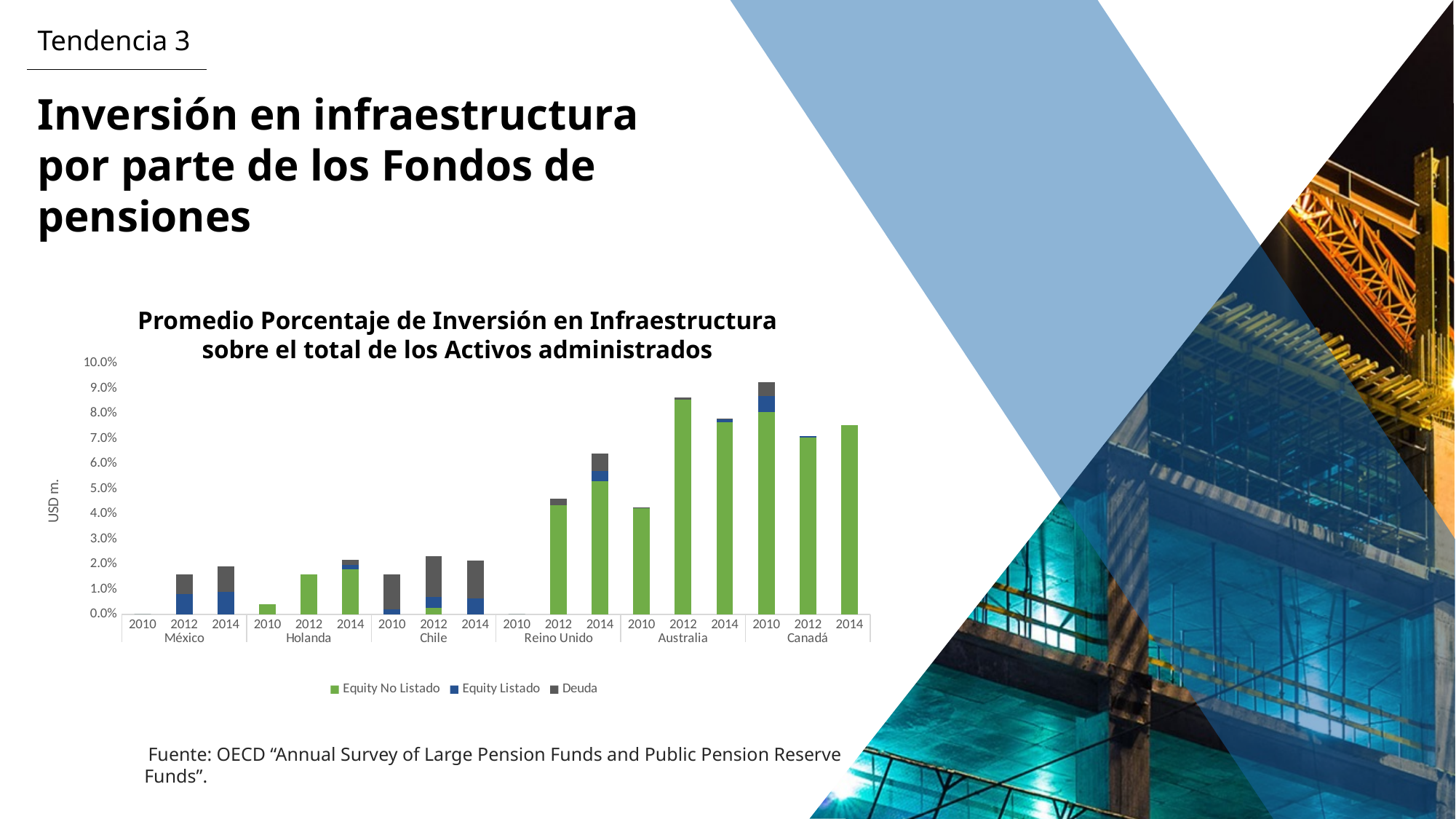
How many countries are shown along the x axis of the chart? 6 How many series does the chart legend list? 3 Is the total value for Chile 2012 greater or less than 2.0%? greater What kind of chart is shown on the slide? Stacked bar chart Which series is shown in green in the chart legend? Equity No Listado Is the total value for Australia 2010 greater or less than 5.0%? less Is the total value for Australia 2012 greater or less than 8.0%? greater Which stacked bar is taller: Australia 2012 or Australia 2014? Australia 2012 Do the stacked bars for Holanda rise or fall from 2010 to 2014? rise Which stacked bar is taller: Chile 2012 or Holanda 2012? Chile 2012 Which country and year has the tallest stacked bar in the chart? Canadá 2010